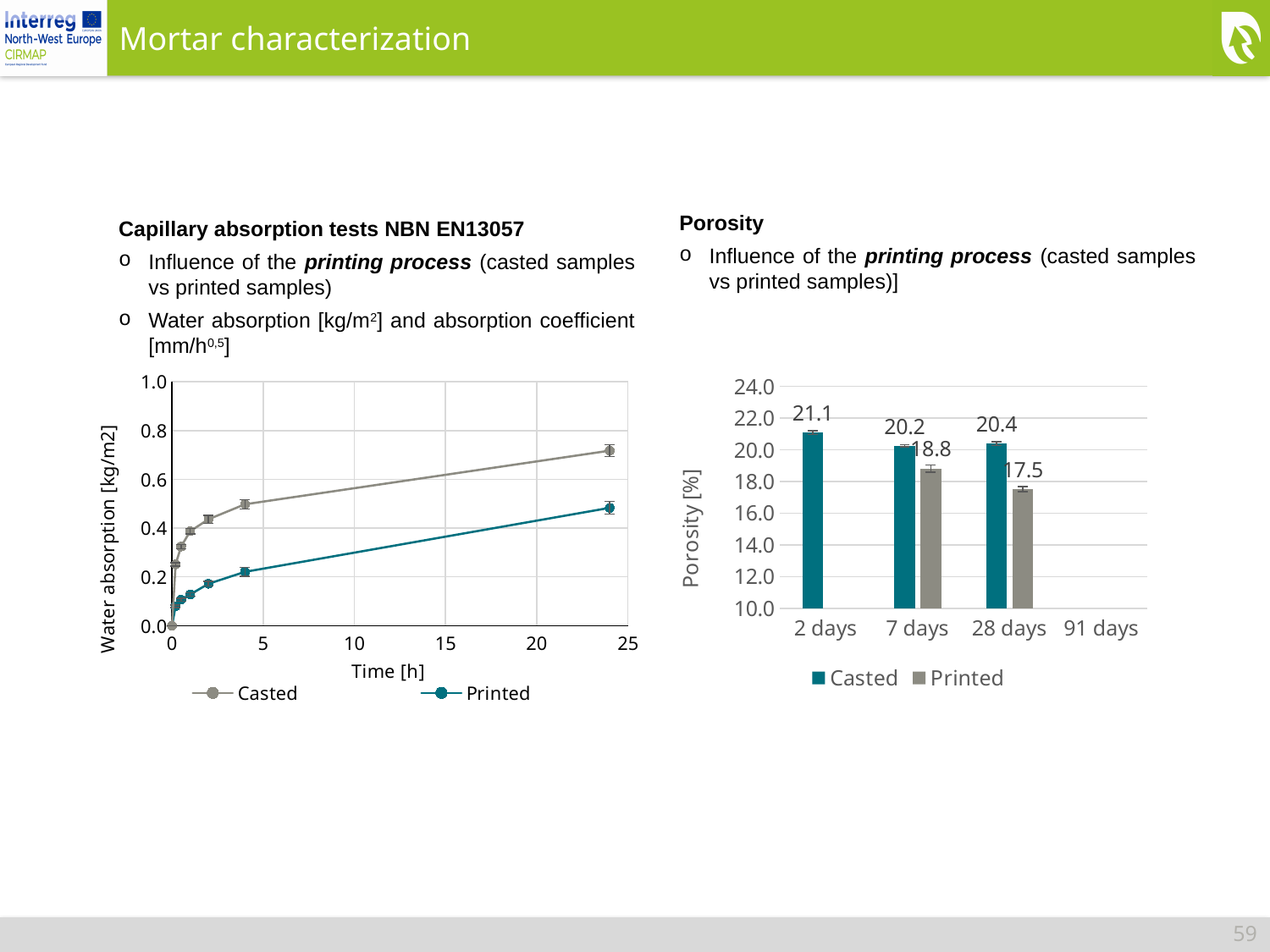
What kind of chart is the Water absorption chart on the left? Line chart In the Porosity chart, what is the porosity of the Printed samples at 28 days? 17.5 In the Porosity chart, what is the difference between the Casted and Printed porosity at 7 days? 1.4 In the Water absorption chart, is the Casted value at the last time point (around 24 h) greater or less than 0.6? greater In the Water absorption chart, which series has the higher water absorption at the last time point, Casted or Printed? Casted In the Porosity chart, what is the porosity of the Printed samples at 7 days? 18.8 In the Porosity chart, at which age is the Casted porosity highest? 2 days In the Porosity chart, how many series does the legend list? 2 In the Porosity chart, what is the porosity of the Casted samples at 2 days? 21.1 What kind of chart is the Porosity chart on the right? Bar chart In the Porosity chart, what is the difference between the Casted and Printed porosity at 28 days? 2.9 In the Porosity chart, which series has the higher porosity at 7 days, Casted or Printed? Casted